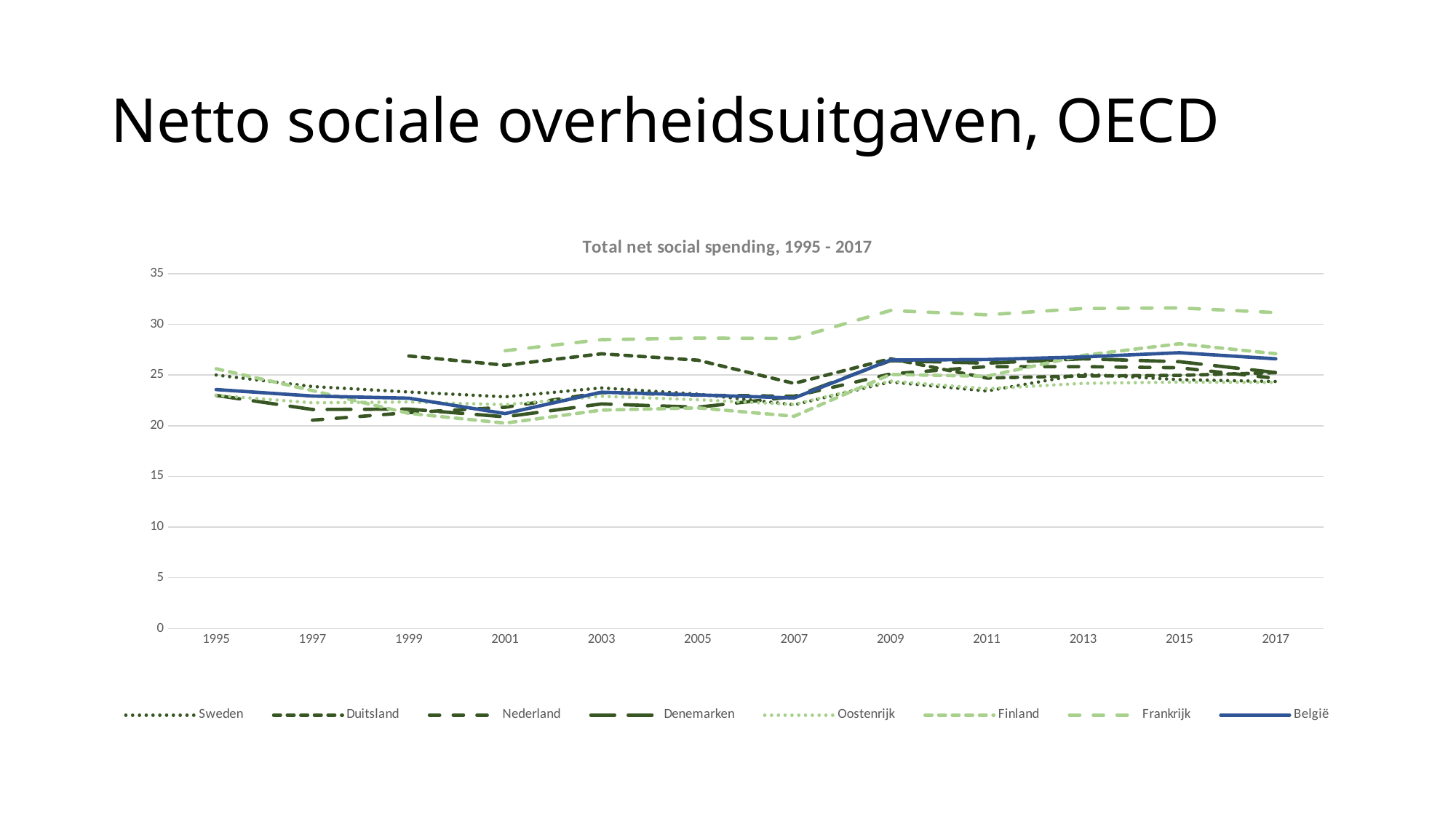
How many series does the legend list? 8 Is the value for België in 2001 greater or less than 25? less What kind of chart is shown on the slide? line chart How many year labels are shown on the x axis? 12 Does the value for Frankrijk rise or fall between 2007 and 2009? rise Which series is drawn as a solid blue line? België Which is larger in 2001, the value for Duitsland or the value for België? Duitsland Is the value for Duitsland in 1999 greater or less than 25? greater Which series has the highest value in 2017? Frankrijk Is the value for Frankrijk in 2017 greater or less than 30? greater Which series has the highest value in 2009? Frankrijk What is the title of the chart? Total net social spending, 1995 - 2017